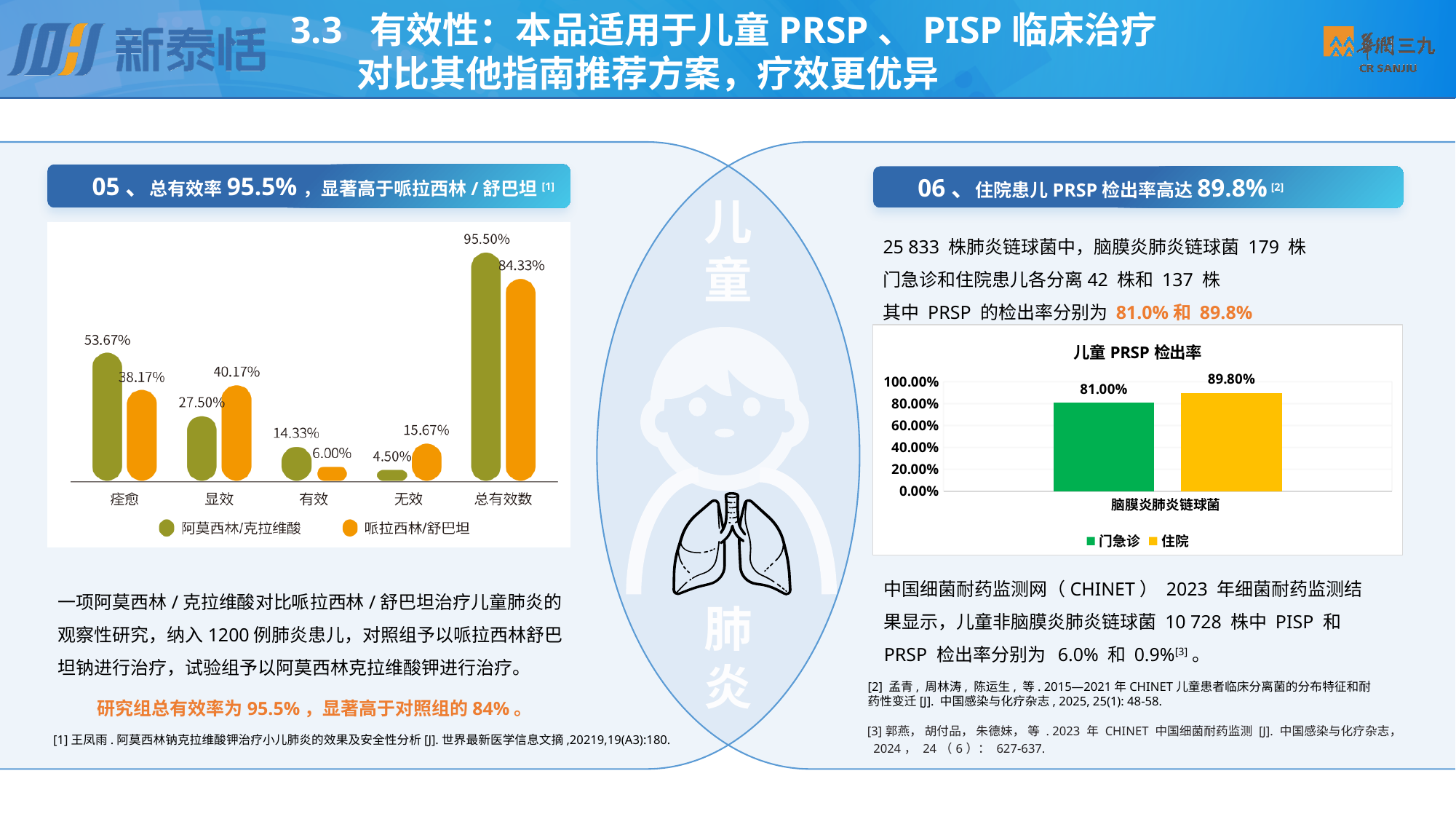
How many series does the legend of the left chart list? 2 In the left chart, what is the value for 哌拉西林/舒巴坦 in the 总有效数 category? 84.33% In the chart titled 儿童 PRSP 检出率, what is the value for 住院? 89.80% In the left chart, which series has the larger value in the 显效 category? 哌拉西林/舒巴坦 What type of chart is the chart titled 儿童 PRSP 检出率? Bar chart In the left chart, what is the difference between the two series in the 总有效数 category? 11.17% In the left chart, what is the value for 阿莫西林/克拉维酸 in the 痊愈 category? 53.67% How many categories are shown on the x axis of the left chart? 5 In the left chart, which category has the lowest value for 阿莫西林/克拉维酸? 无效 In the left chart, what is the value for 哌拉西林/舒巴坦 in the 无效 category? 15.67% In the chart titled 儿童 PRSP 检出率, what is the difference between 住院 and 门急诊? 8.80% In the chart titled 儿童 PRSP 检出率, what colour is the bar for 门急诊? Green